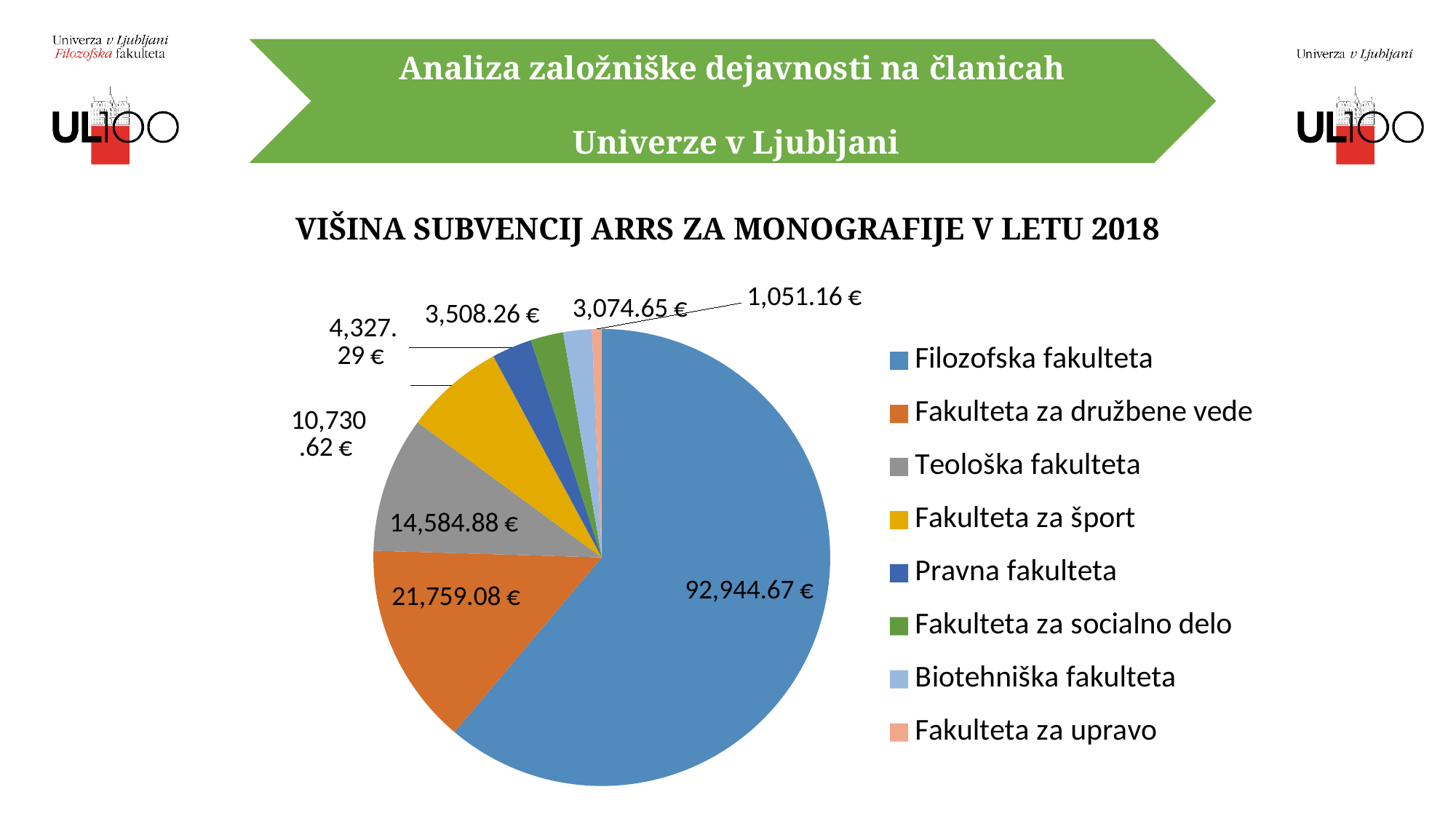
What is the difference between the values for Filozofska fakulteta and Fakulteta za družbene vede? 71,185.59 € What kind of chart is shown on the slide? pie chart Which legend entry is shown in grey? Teološka fakulteta Which faculty received the largest subsidy? Filozofska fakulteta What is the value for Fakulteta za družbene vede? 21,759.08 € What is the value for Fakulteta za upravo? 1,051.16 € What is the title of the chart? VIŠINA SUBVENCIJ ARRS ZA MONOGRAFIJE V LETU 2018 Which faculty received the smallest subsidy? Fakulteta za upravo What is the value for Teološka fakulteta? 14,584.88 € What is the value for Filozofska fakulteta? 92,944.67 € How many slices does the pie chart have? 8 Which received more: Pravna fakulteta or Fakulteta za socialno delo? Pravna fakulteta